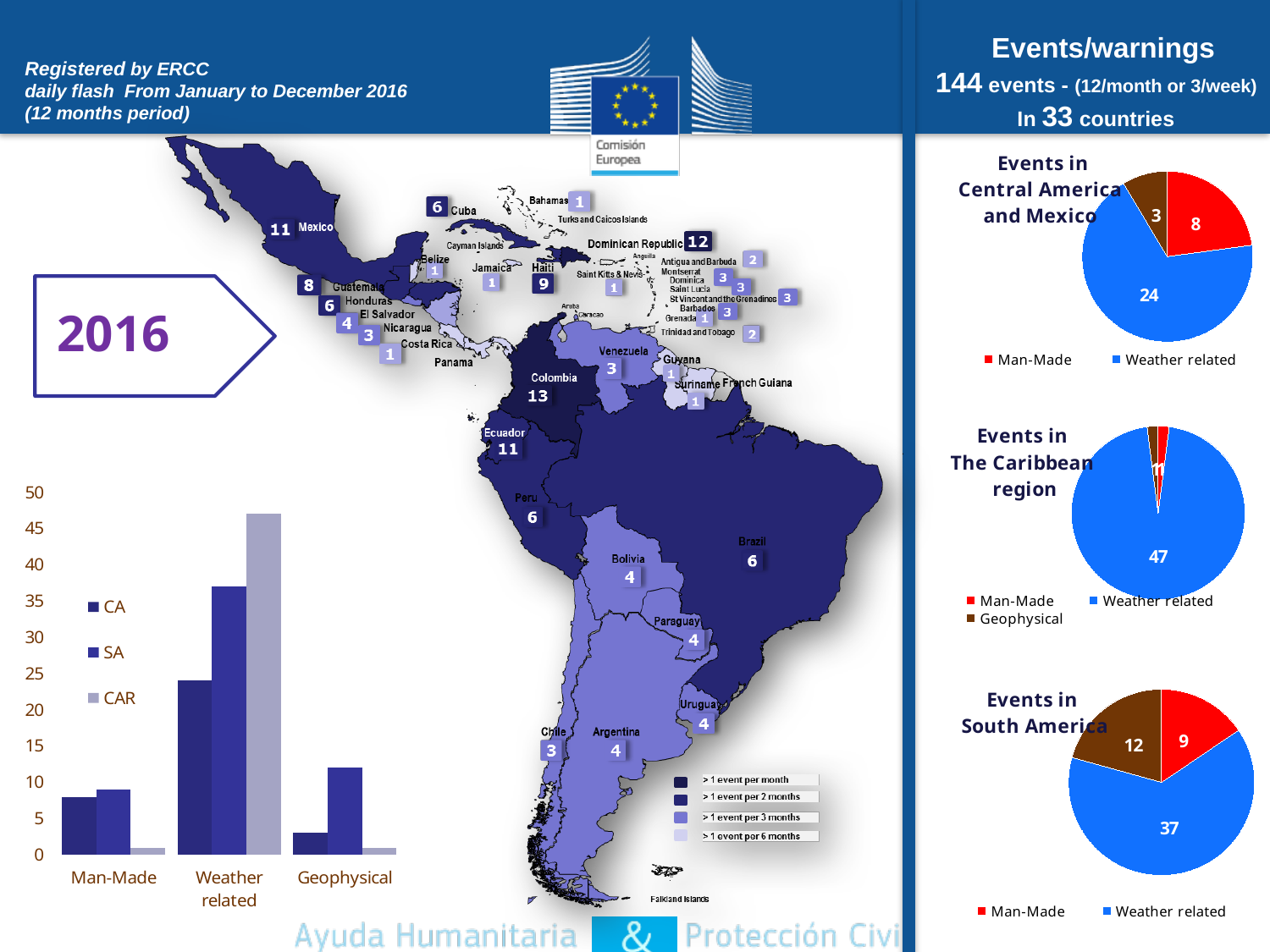
How many series does the legend of the bottom-left bar chart list? 3 In the bottom-left bar chart, is the CAR value for Weather related greater or less than 45? greater In the bottom-left bar chart, which series has the larger value for Weather related, CA or CAR? CAR In the 'Events in Central America and Mexico' pie chart, what is the value of the Weather related slice? 24 In the 'Events in Central America and Mexico' pie chart, what is the value of the Man-Made slice? 8 In the 'Events in South America' pie chart, which slice is the largest? Weather related How many categories are shown on the x axis of the bottom-left bar chart? 3 In the 'Events in The Caribbean region' pie chart, what is the value of the Weather related slice? 47 What kind of chart is the chart at the bottom left of the slide? bar chart In the 'Events in South America' pie chart, what is the difference between the Weather related slice and the Man-Made slice? 28 In the bottom-left bar chart, is the SA value for Geophysical greater or less than 10? greater In the bottom-left bar chart, which category has the tallest bars overall? Weather related